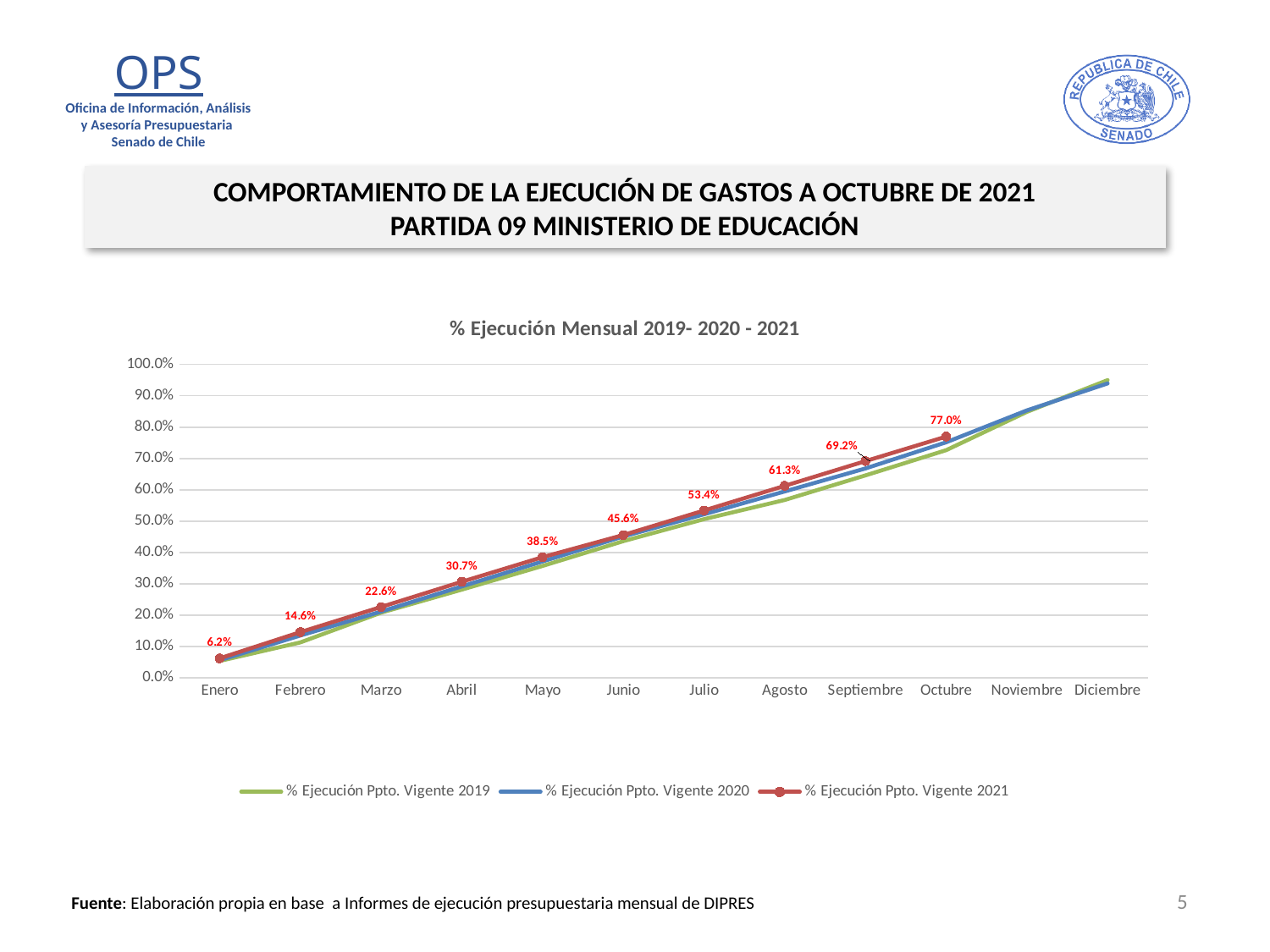
What is the value of % Ejecución Ppto. Vigente 2021 for Octubre? 77.0% How many series does the legend list? 3 What is the value of % Ejecución Ppto. Vigente 2021 for Julio? 53.4% Which month has the highest value for % Ejecución Ppto. Vigente 2021? Octubre What is the chart's title? % Ejecución Mensual 2019- 2020 - 2021 What is the difference between the % Ejecución Ppto. Vigente 2021 values for Octubre and Septiembre? 7.8% How many months are shown on the x axis? 12 Does the % Ejecución Ppto. Vigente 2021 series rise or fall from Enero to Octubre? rise What is the value of % Ejecución Ppto. Vigente 2021 for Enero? 6.2% What is the value of % Ejecución Ppto. Vigente 2021 for Abril? 30.7% What type of chart is shown on the slide? line chart Is the value of % Ejecución Ppto. Vigente 2019 for Diciembre greater or less than 90.0%? greater